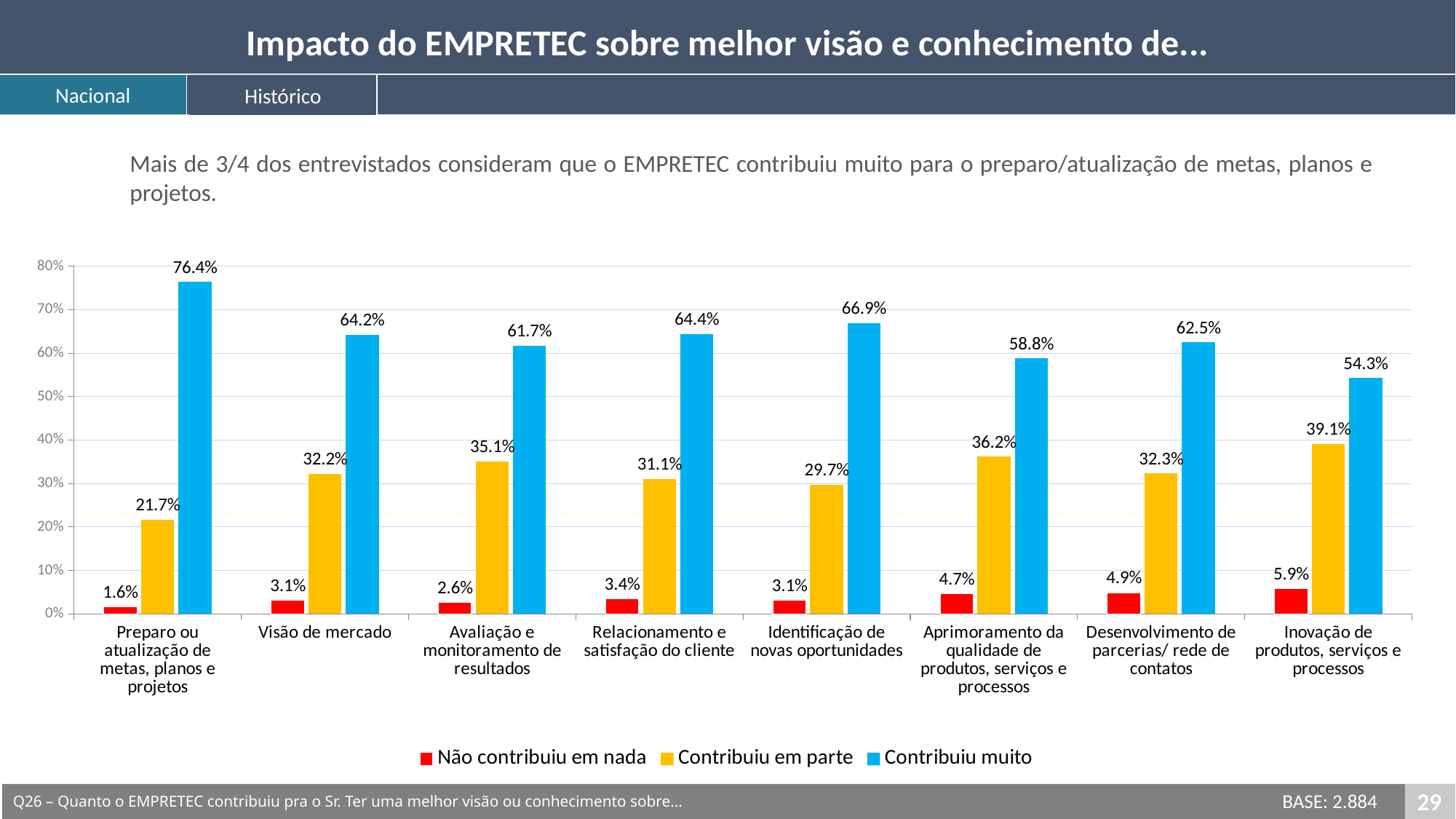
How many categories are shown on the x axis of the chart? 8 Which is larger: the "Contribuiu em parte" value for "Visão de mercado" or for "Inovação de produtos, serviços e processos"? Inovação de produtos, serviços e processos What is the value of "Contribuiu em parte" for "Aprimoramento da qualidade de produtos, serviços e processos"? 36.2% Which category has the highest value for "Não contribuiu em nada"? Inovação de produtos, serviços e processos Which category has the highest value for "Contribuiu muito"? Preparo ou atualização de metas, planos e projetos Which category has the lowest value for "Contribuiu muito"? Inovação de produtos, serviços e processos What kind of chart is shown on the slide? Bar chart How many series does the chart legend list? 3 Is the "Contribuiu muito" value for "Identificação de novas oportunidades" greater or less than 60%? greater What is the difference in percentage points between the "Contribuiu muito" values for "Preparo ou atualização de metas, planos e projetos" and "Inovação de produtos, serviços e processos"? 22.1 percentage points What is the value of "Não contribuiu em nada" for "Desenvolvimento de parcerias/ rede de contatos"? 4.9% What is the value of "Contribuiu muito" for "Preparo ou atualização de metas, planos e projetos"? 76.4%